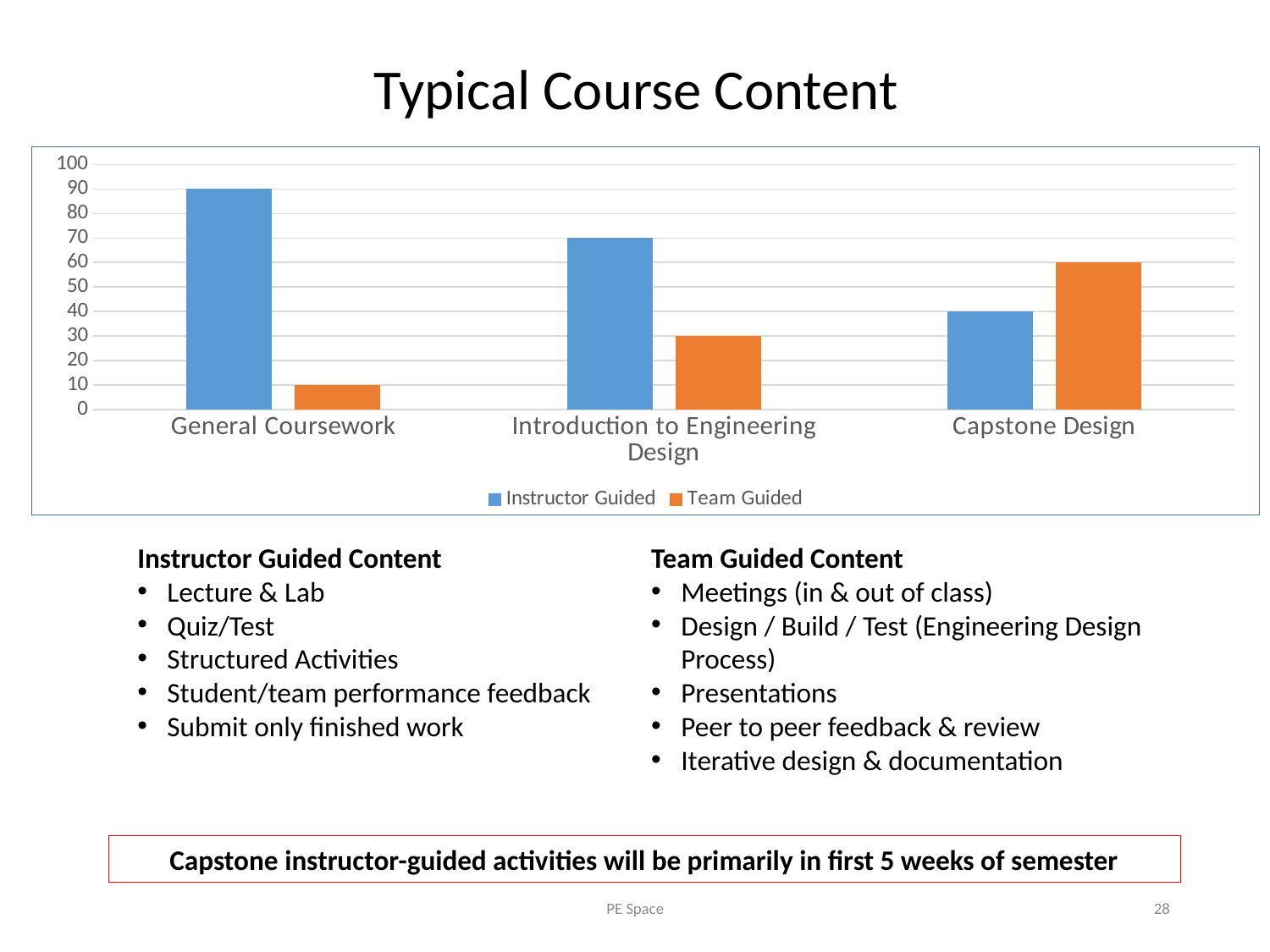
How many categories are shown on the x axis? 3 Which category has the highest Instructor Guided value? General Coursework What is the difference between the Instructor Guided and Team Guided values for Introduction to Engineering Design? 40 What kind of chart is shown on the slide? bar chart Do the Instructor Guided values rise or fall from left to right across the categories? fall Which category has the lowest Team Guided value? General Coursework What is the Instructor Guided value for General Coursework? 90 For Capstone Design, which is larger: Instructor Guided or Team Guided? Team Guided Is the Team Guided value for General Coursework greater or less than 20? less How many series does the legend list? 2 What is the Team Guided value for Capstone Design? 60 What is the Instructor Guided value for Introduction to Engineering Design? 70